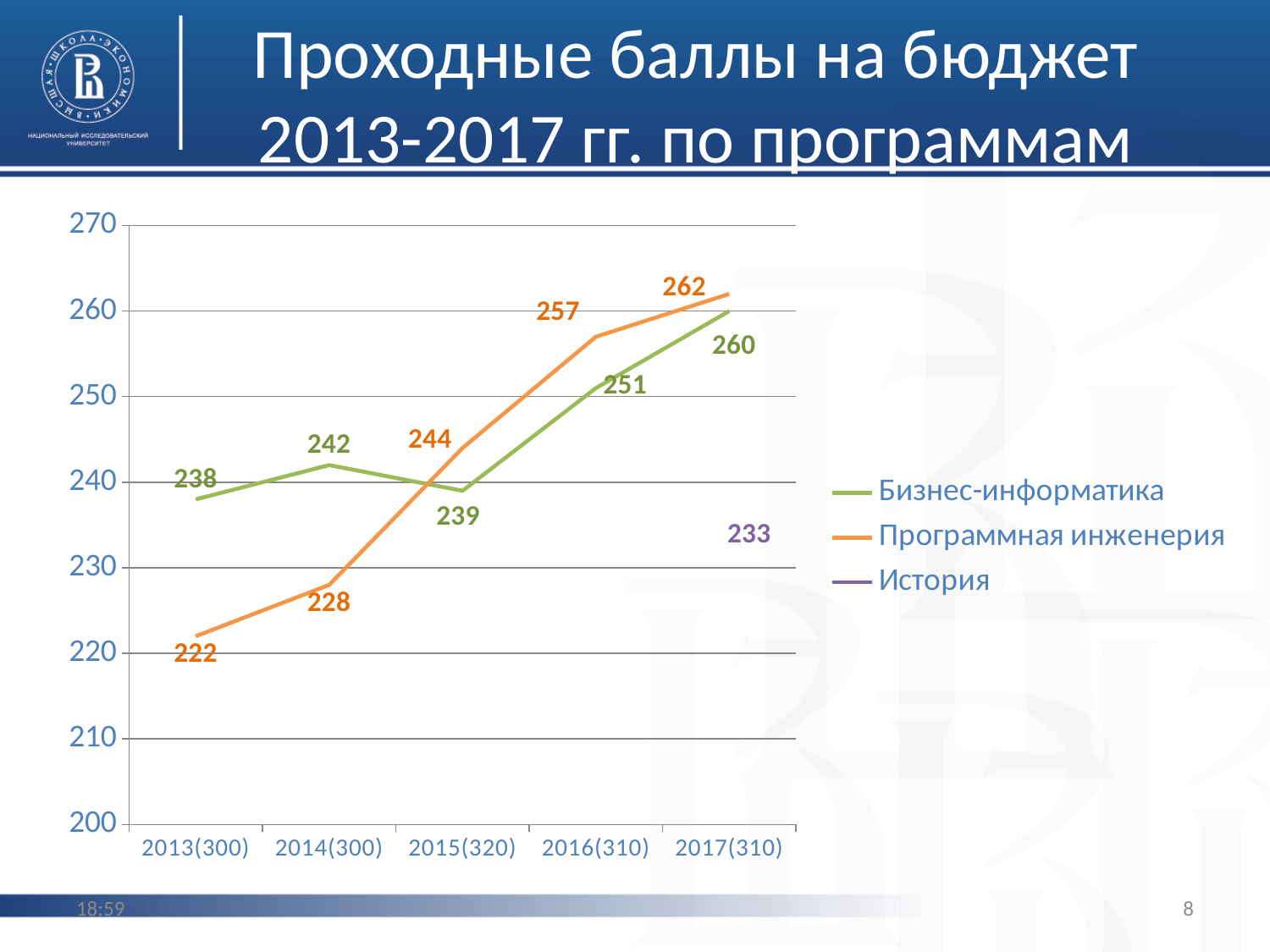
In which category does Программная инженерия reach its highest value? 2017(310) How many series does the legend list? 3 What is the value for Программная инженерия in 2015(320)? 244 Which series has the larger value in 2014(300), Бизнес-информатика or Программная инженерия? Бизнес-информатика What type of chart is shown on the slide? line chart What is the value for Бизнес-информатика in 2013(300)? 238 Does the value for Программная инженерия rise or fall from 2013(300) to 2017(310)? rise What is the difference between Программная инженерия and Бизнес-информатика in 2016(310)? 6 What colour is the line for Программная инженерия? orange In which category does Бизнес-информатика have its lowest value? 2013(300) What is the value for История in 2017(310)? 233 How many categories are shown on the x axis? 5